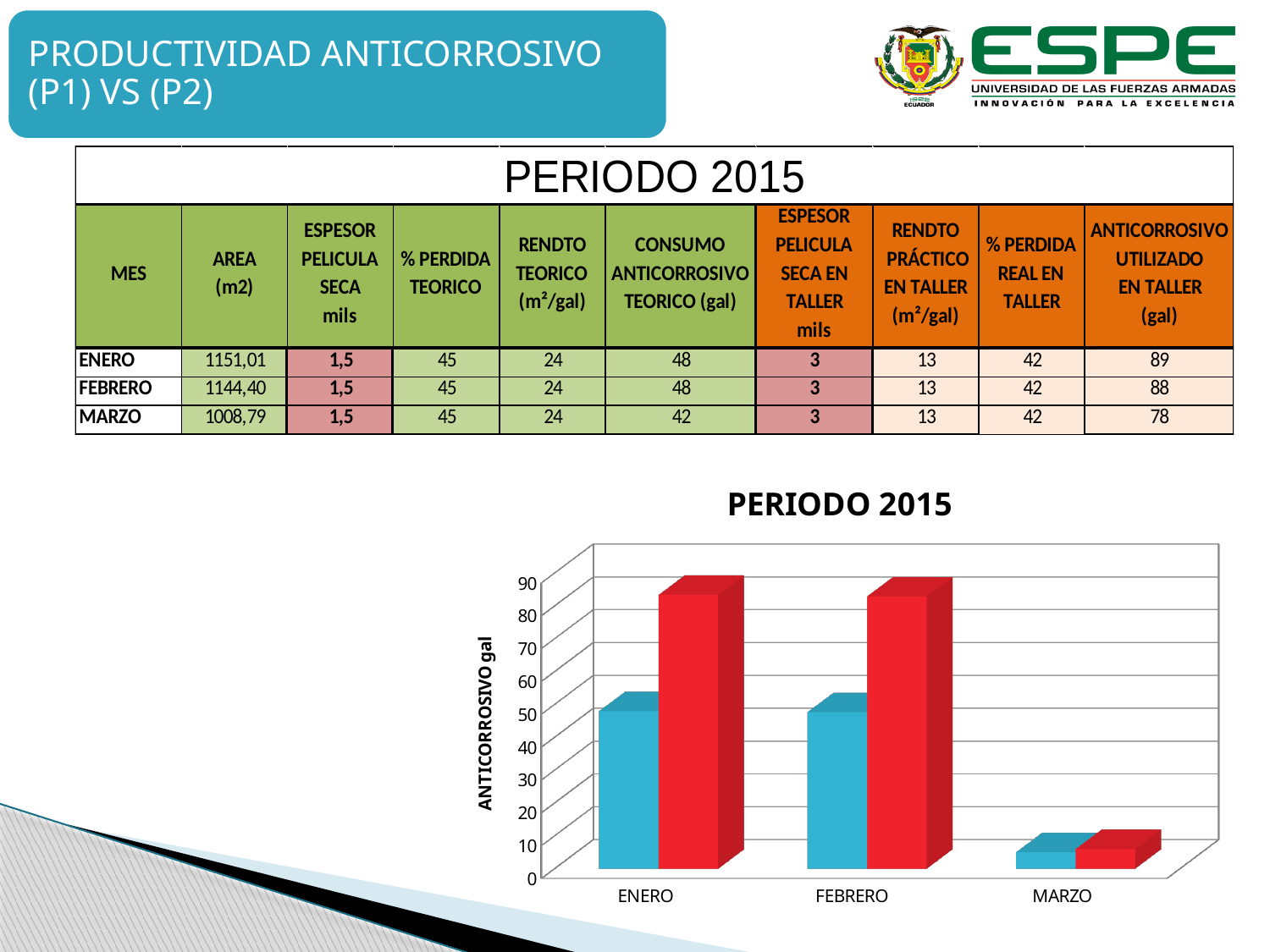
Do the bar values rise or fall from FEBRERO to MARZO? fall Is the value of the blue bar for FEBRERO greater or less than 30? greater Which blue bar is taller, FEBRERO or MARZO? FEBRERO Is the value of the blue bar for ENERO greater or less than 60? less Which month has the lowest red bar? MARZO How many months are shown on the x axis of the chart? 3 What is the title of the chart? PERIODO 2015 Is the value of the red bar for MARZO greater or less than 20? less What is the label on the vertical axis of the chart? ANTICORROSIVO gal What kind of chart is shown on the slide? bar chart For ENERO, which bar is taller, the red one or the blue one? the red one